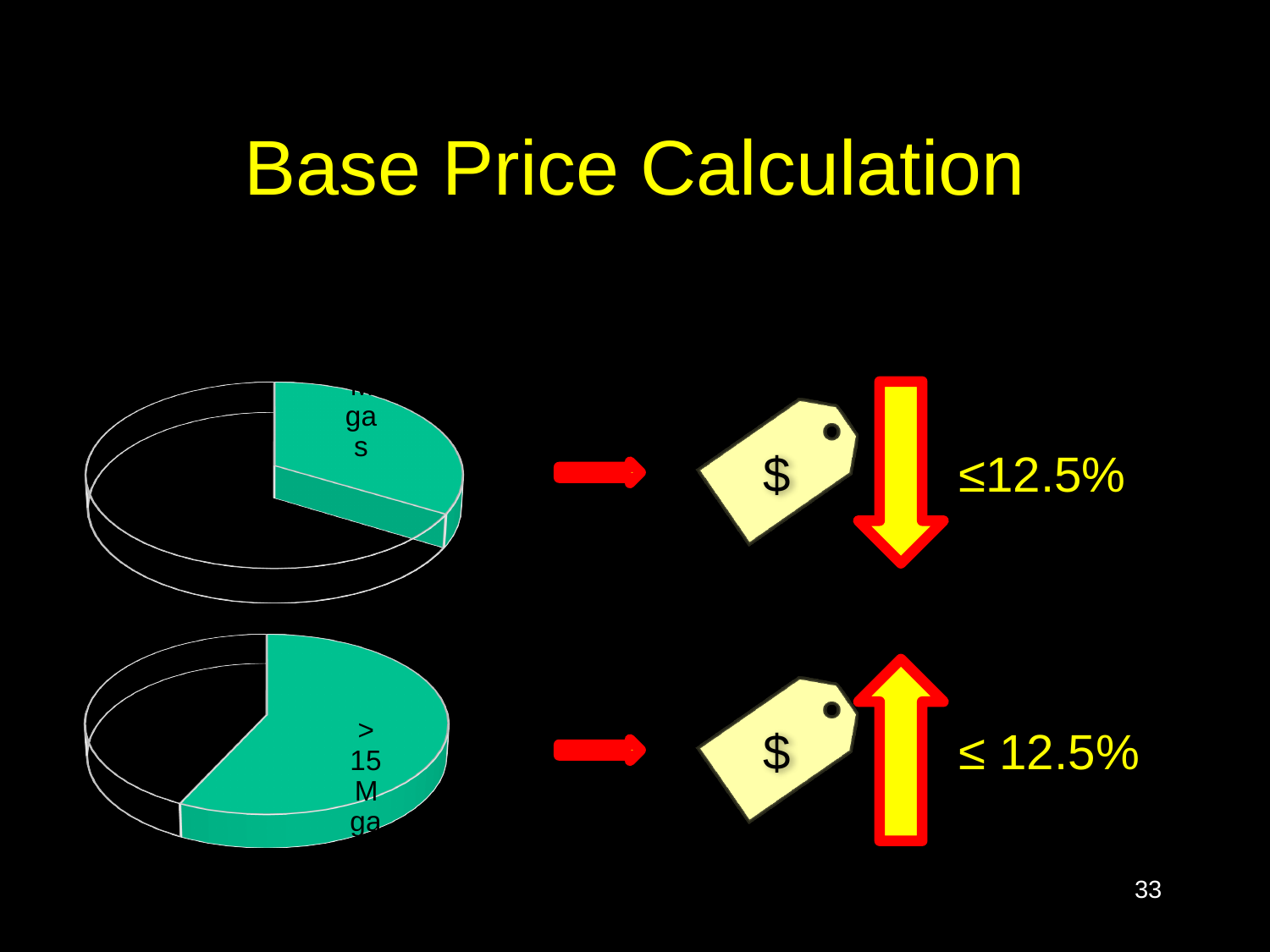
What is the title of the slide containing the pie charts? Base Price Calculation In the top pie chart, is the green slice more or less than half of the pie? less How many pie charts are on the slide? 2 What is the label of the green slice in the bottom pie chart? > 15 M gas In the bottom pie chart, is the green slice more or less than half of the pie? greater What colour is the highlighted slice in each pie chart? green What kind of chart is shown on the left side of the slide? pie chart Which pie chart has the larger green slice, the top one or the bottom one? the bottom one